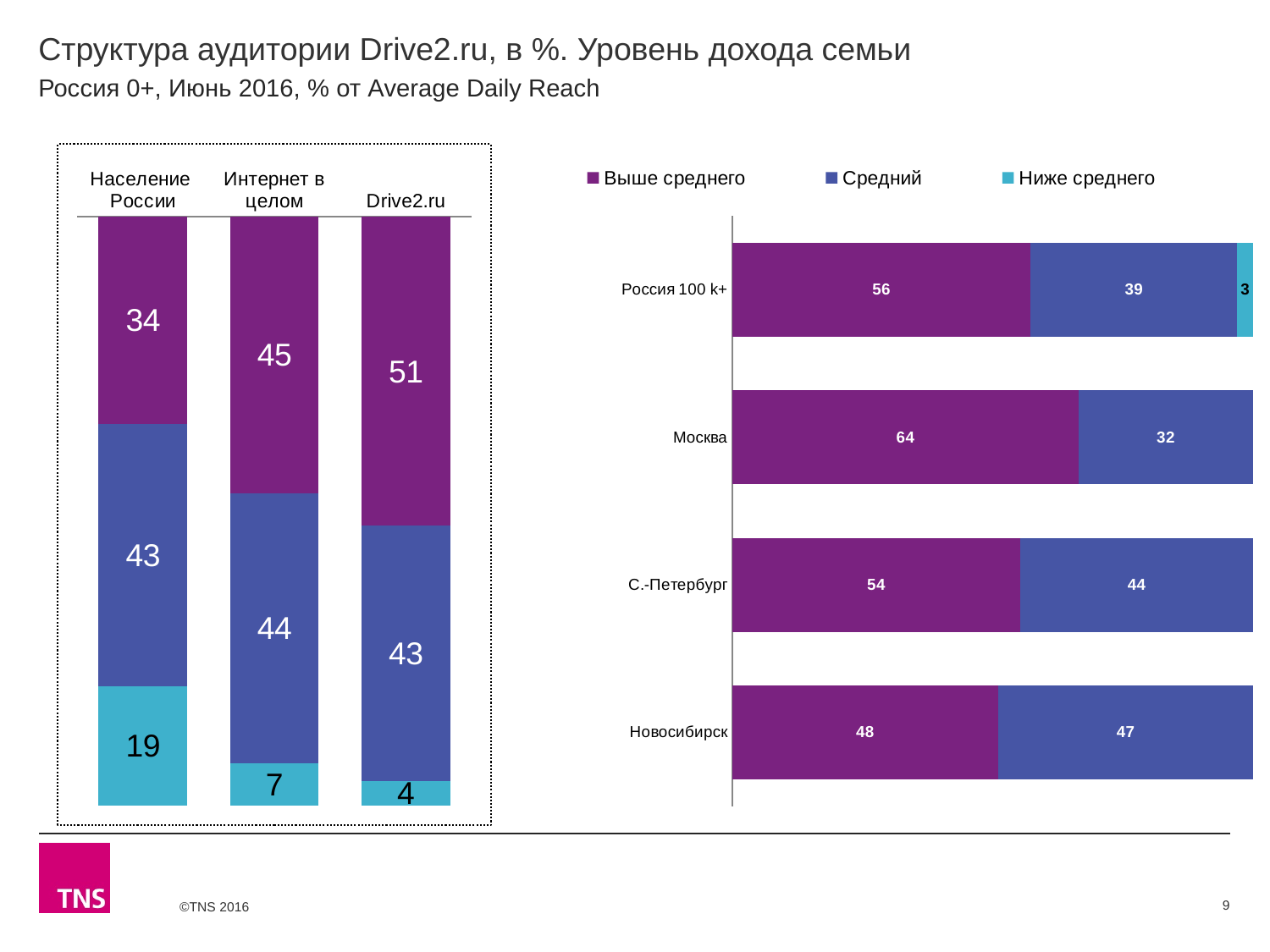
How many series does the legend of the right chart list? 3 In the right chart, what is the Выше среднего value for Москва? 64 In the right chart, what is the Ниже среднего value for Россия 100 k+? 3 In the left chart, how many bars are shown? 3 In the left chart, what is the value of the top (purple) segment for Drive2.ru? 51 In the right chart, which category has the highest Выше среднего value? Москва In the right chart, is the Средний value larger for С.-Петербург or for Москва? С.-Петербург In the right chart, what is the Средний value for Новосибирск? 47 In the left chart, what is the value of the middle (blue) segment for Интернет в целом? 44 In the left chart, what is the value of the bottom (light blue) segment for Население России? 19 In the left chart, which bar has the smallest bottom (light blue) segment? Drive2.ru In the left chart, what is the difference between the top segment of Drive2.ru and the top segment of Население России? 17